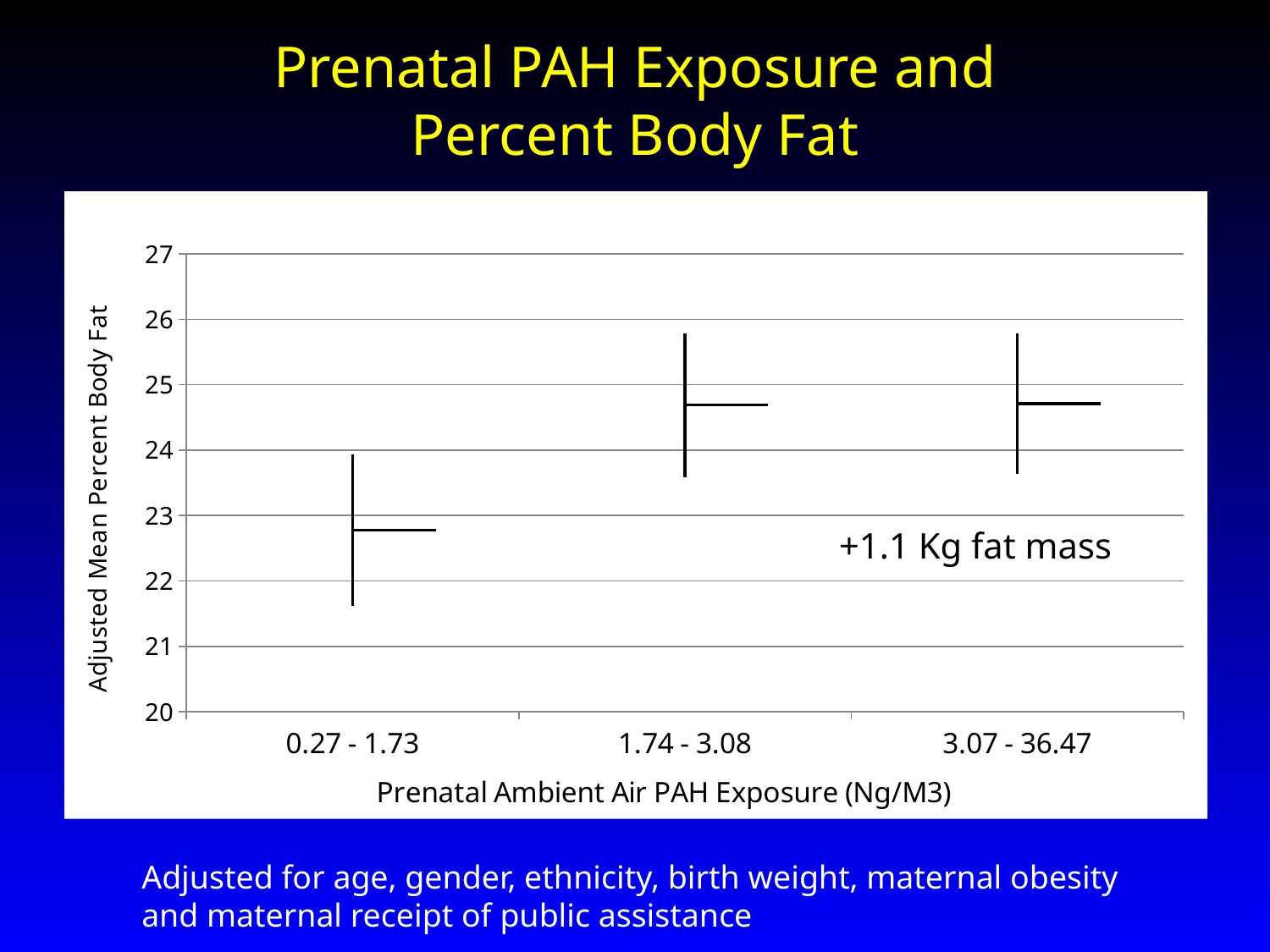
Does the adjusted mean percent body fat rise or fall from the 0.27 - 1.73 category to the 1.74 - 3.08 category? rise Which exposure category has the lowest adjusted mean percent body fat? 0.27 - 1.73 What is the lowest value shown on the y axis? 20 Is the adjusted mean percent body fat for the 1.74 - 3.08 category greater or less than 24? greater Is the adjusted mean percent body fat for the 3.07 - 36.47 category greater or less than 25? less What is the label of the y axis? Adjusted Mean Percent Body Fat Which has the higher adjusted mean percent body fat, the 0.27 - 1.73 category or the 1.74 - 3.08 category? 1.74 - 3.08 How many exposure categories are plotted on the x axis? 3 Is the adjusted mean percent body fat for the 0.27 - 1.73 category greater or less than 23? less What annotation text is printed inside the plot area? +1.1 Kg fat mass